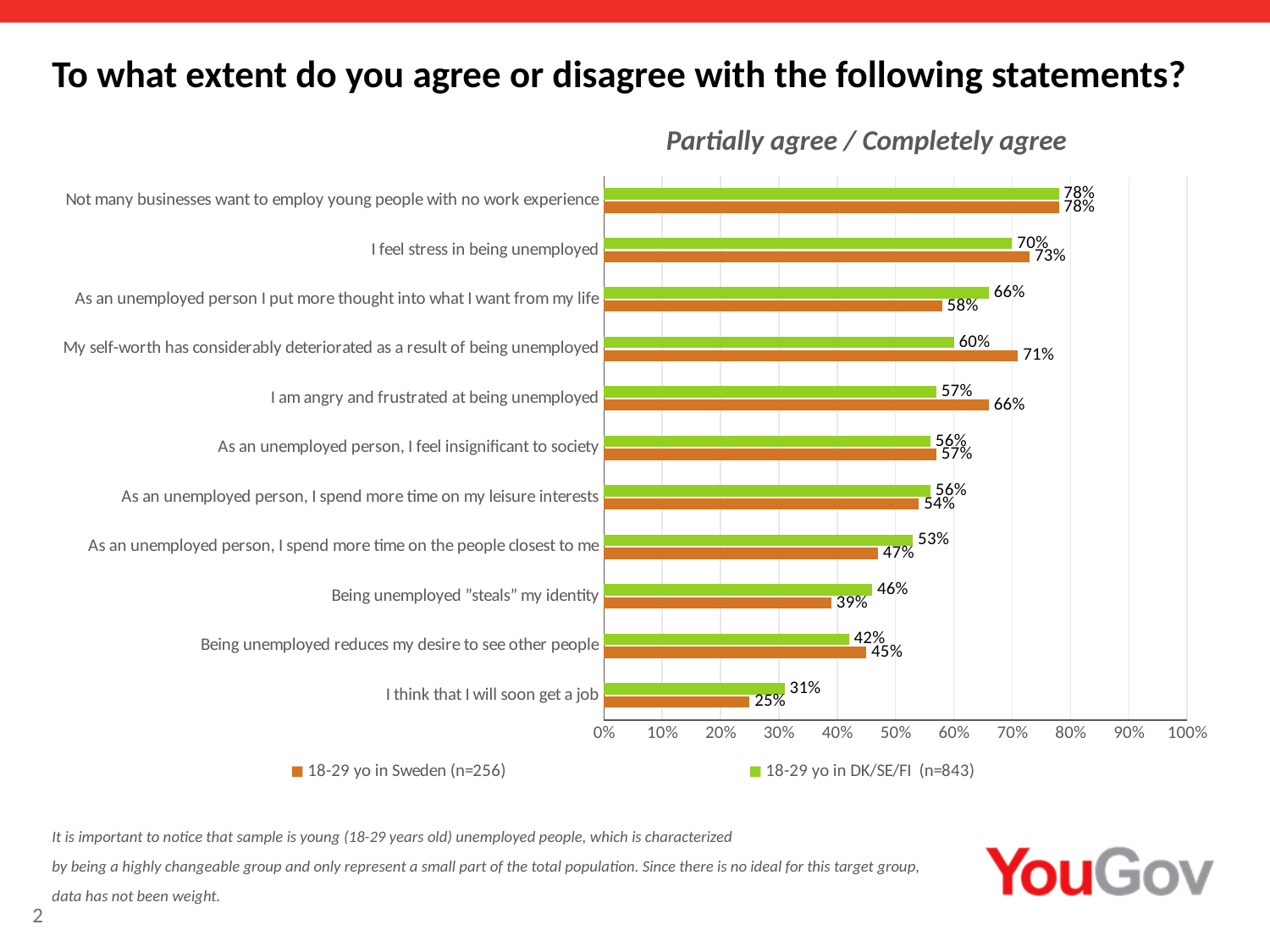
Which statement has the lowest agreement among 18-29 year olds in Sweden? I think that I will soon get a job What is the value for 'I think that I will soon get a job' among 18-29 year olds in Sweden? 25% What type of chart is shown on the slide? Bar chart How many statements are shown in the chart? 11 Which statement has the highest agreement among 18-29 year olds in DK/SE/FI? Not many businesses want to employ young people with no work experience For 'As an unemployed person I put more thought into what I want from my life', which group has the higher value: Sweden or DK/SE/FI? DK/SE/FI Is the Sweden value for 'I am angry and frustrated at being unemployed' greater or less than 60%? greater How many series does the legend list? 2 What percentage of 18-29 year olds in Sweden agree that 'I feel stress in being unemployed'? 73% Which colour represents 18-29 year olds in Sweden (n=256)? Orange What percentage of 18-29 year olds in DK/SE/FI agree that 'Being unemployed "steals" my identity'? 46% What is the difference between the Sweden and DK/SE/FI values for 'My self-worth has considerably deteriorated as a result of being unemployed'? 11%